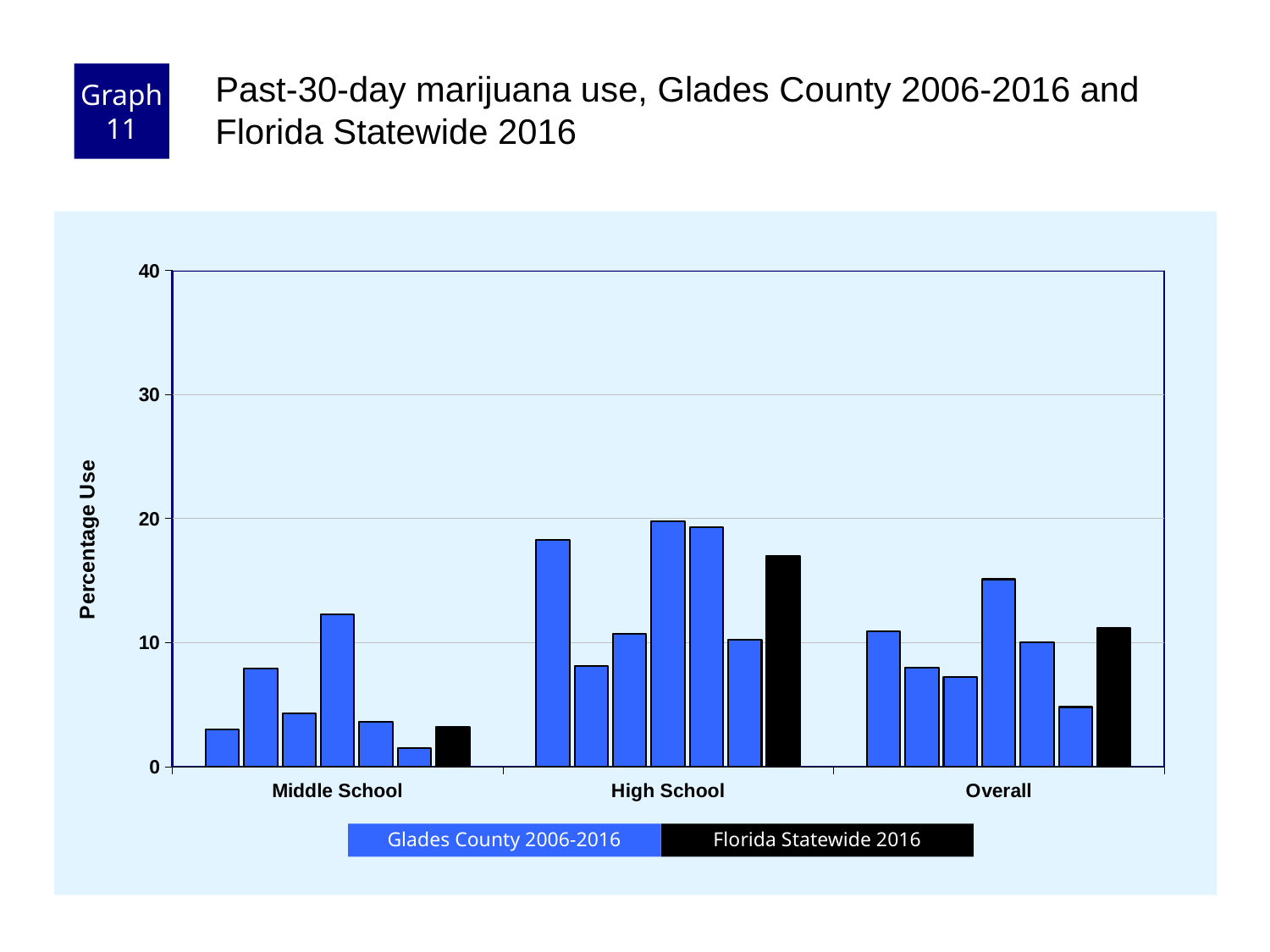
Which is larger, the Florida Statewide 2016 value for High School or for Middle School? High School Which category has the highest Florida Statewide 2016 value? High School Is the Florida Statewide 2016 value for High School greater or less than 20? less How many series does the legend list? 2 What is the title of the y axis? Percentage Use Is the Florida Statewide 2016 value for Middle School greater or less than 10? less What kind of chart is shown on the slide? bar chart How many categories are shown on the x axis? 3 Is the tallest Glades County bar in the Middle School group greater or less than 10? greater Which category has the lowest Florida Statewide 2016 value? Middle School